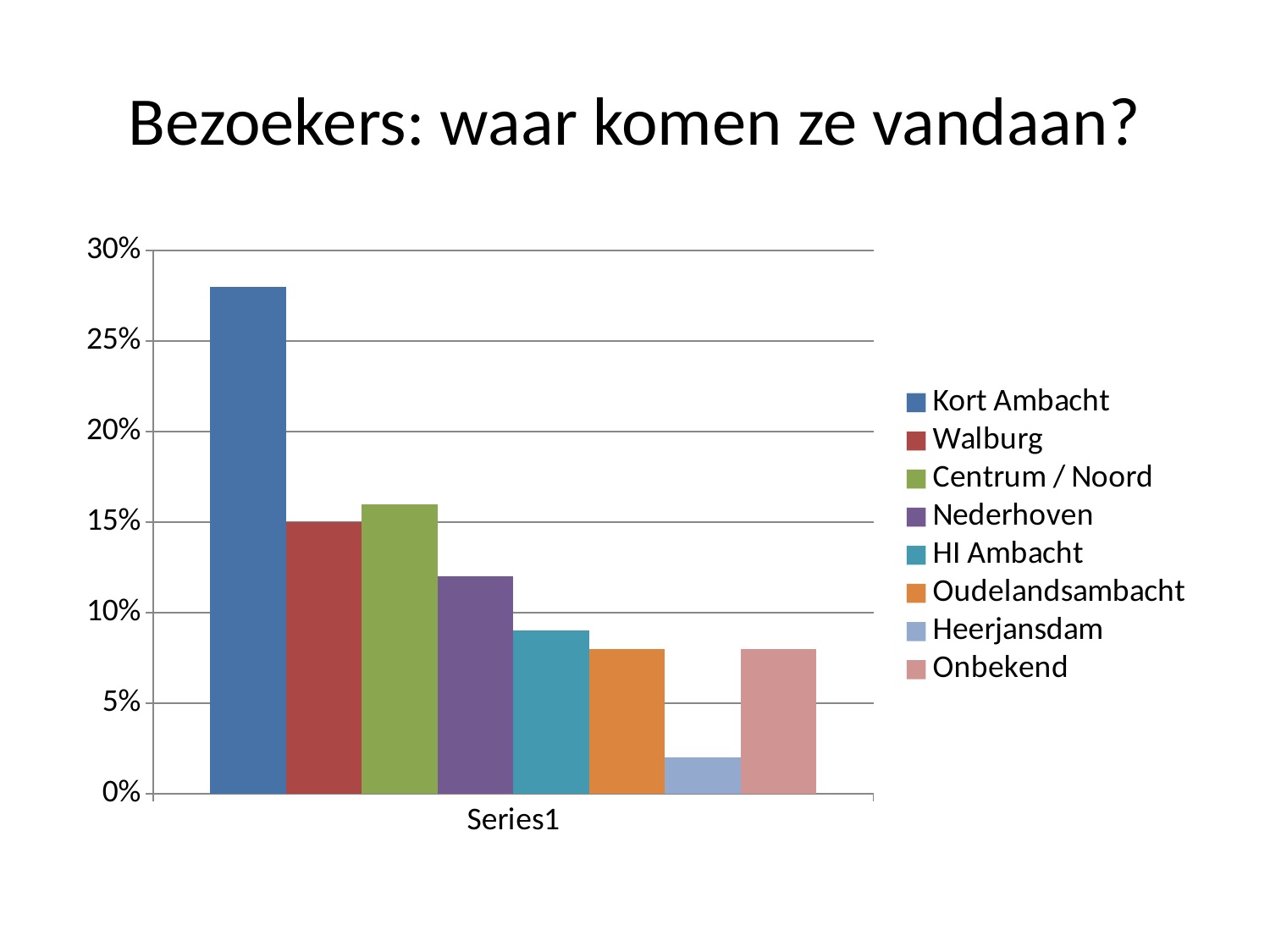
Which is larger, the value for Nederhoven or the value for Heerjansdam? Nederhoven What is the value for Walburg? 15% Which category has the lowest value? Heerjansdam Which is larger, the value for Kort Ambacht or the value for Centrum / Noord? Kort Ambacht Is the value for HI Ambacht greater or less than 10%? less What is the title of the chart on the slide? Bezoekers: waar komen ze vandaan? How many entries does the legend list? 8 Is the value for Nederhoven greater or less than 10%? greater What kind of chart is shown on the slide? bar chart Which category has the highest value? Kort Ambacht Is the value for Kort Ambacht greater or less than 25%? greater